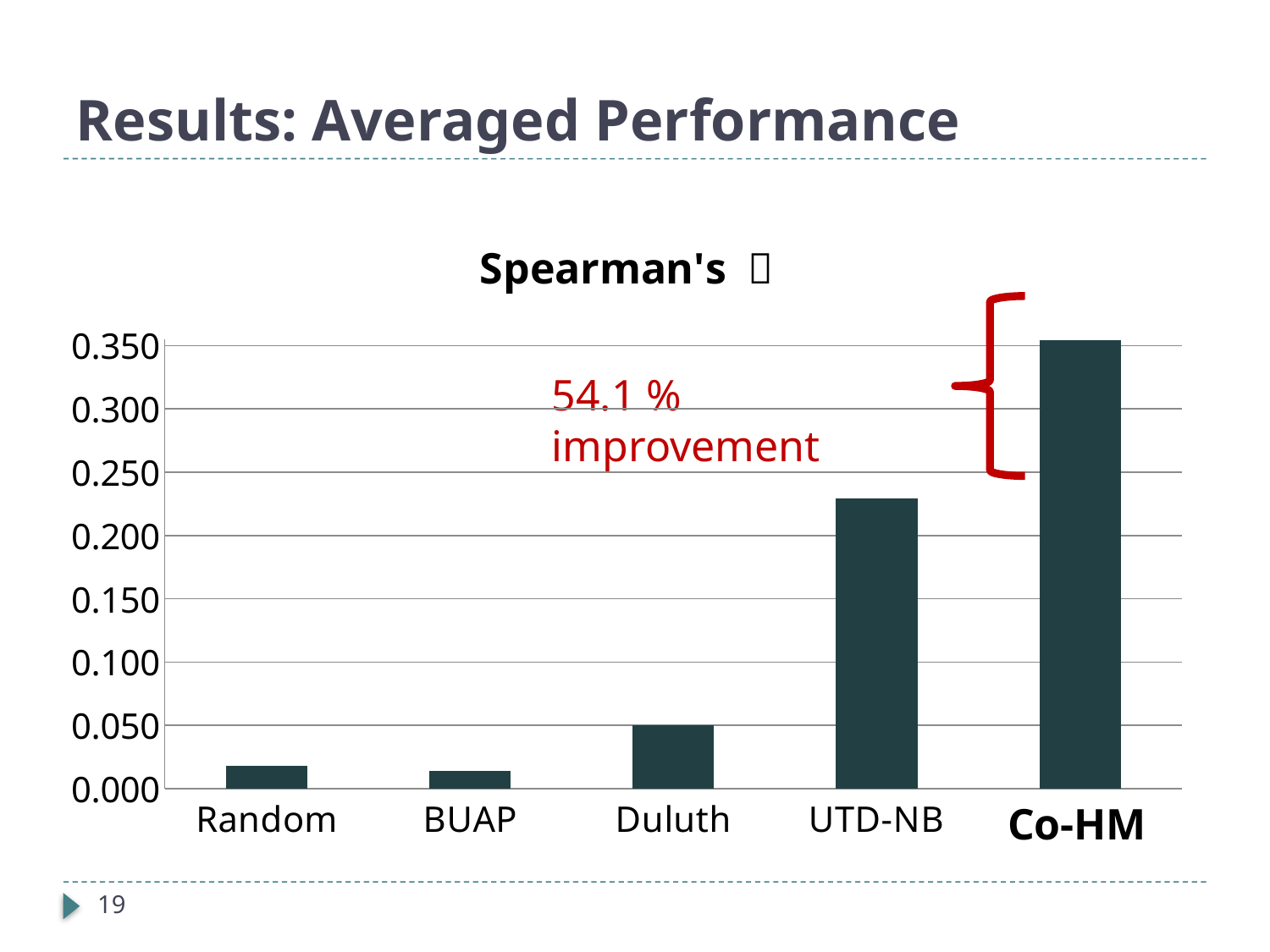
Is the value for Duluth greater or less than 0.100? less Which has a larger value, Co-HM or UTD-NB? Co-HM Which category has the highest value? Co-HM Is the value for Random greater or less than 0.050? less Is the value for UTD-NB greater or less than 0.200? greater How many categories are plotted on the x axis? 5 Which has a larger value, UTD-NB or Duluth? UTD-NB What percentage improvement does the red annotation on the chart state? 54.1 % What kind of chart is shown on the slide? bar chart Do the values generally rise or fall from left to right across the categories? rise